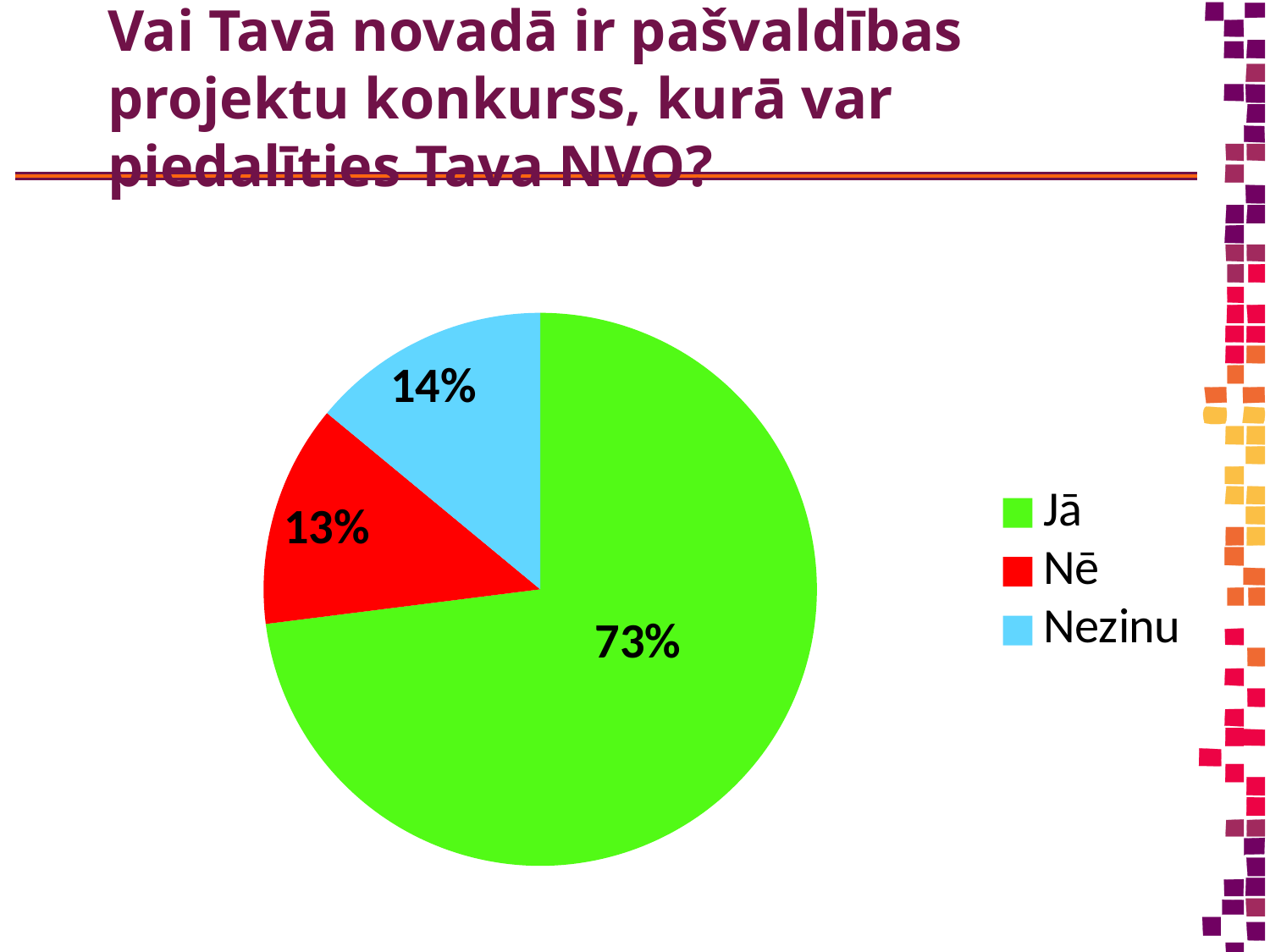
What is the difference in percentage points between "Jā" and "Nezinu"? 59 Which category has the largest slice of the pie? Jā Which colour represents "Nē" in the pie chart? red How many categories does the pie chart show? 3 How many entries does the legend list? 3 What share of the pie does "Nē" have? 13% What is the difference in percentage points between "Nezinu" and "Nē"? 1 What kind of chart is shown on the slide? pie chart What share of the pie does "Jā" have? 73% What share of the pie does "Nezinu" have? 14% Which category has the smallest slice of the pie? Nē Which colour represents "Nezinu" in the pie chart? light blue